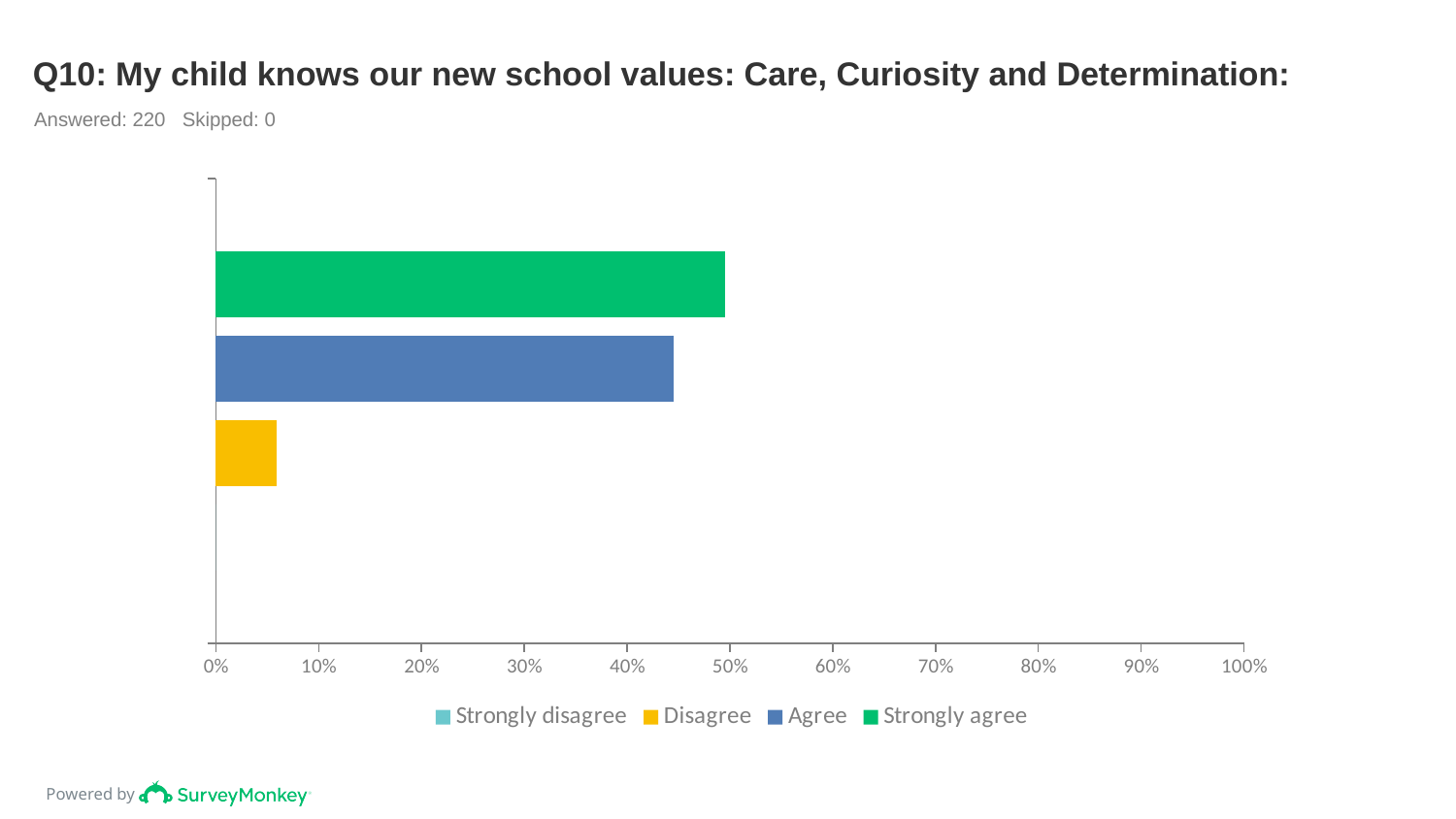
Of Disagree, Agree and Strongly agree, which has the lowest value? Disagree How many series does the legend list? 4 What colour is the bar for Strongly agree? green How many respondents answered this question according to the slide? 220 Which is larger, the value for Agree or the value for Disagree? Agree Is the value for Disagree greater or less than 10%? less Is the value for Strongly agree greater or less than 40%? greater Which response option has the highest value? Strongly agree Which is larger, the value for Strongly agree or the value for Agree? Strongly agree What kind of chart is shown on the slide? bar chart Is the value for Agree greater or less than 50%? less